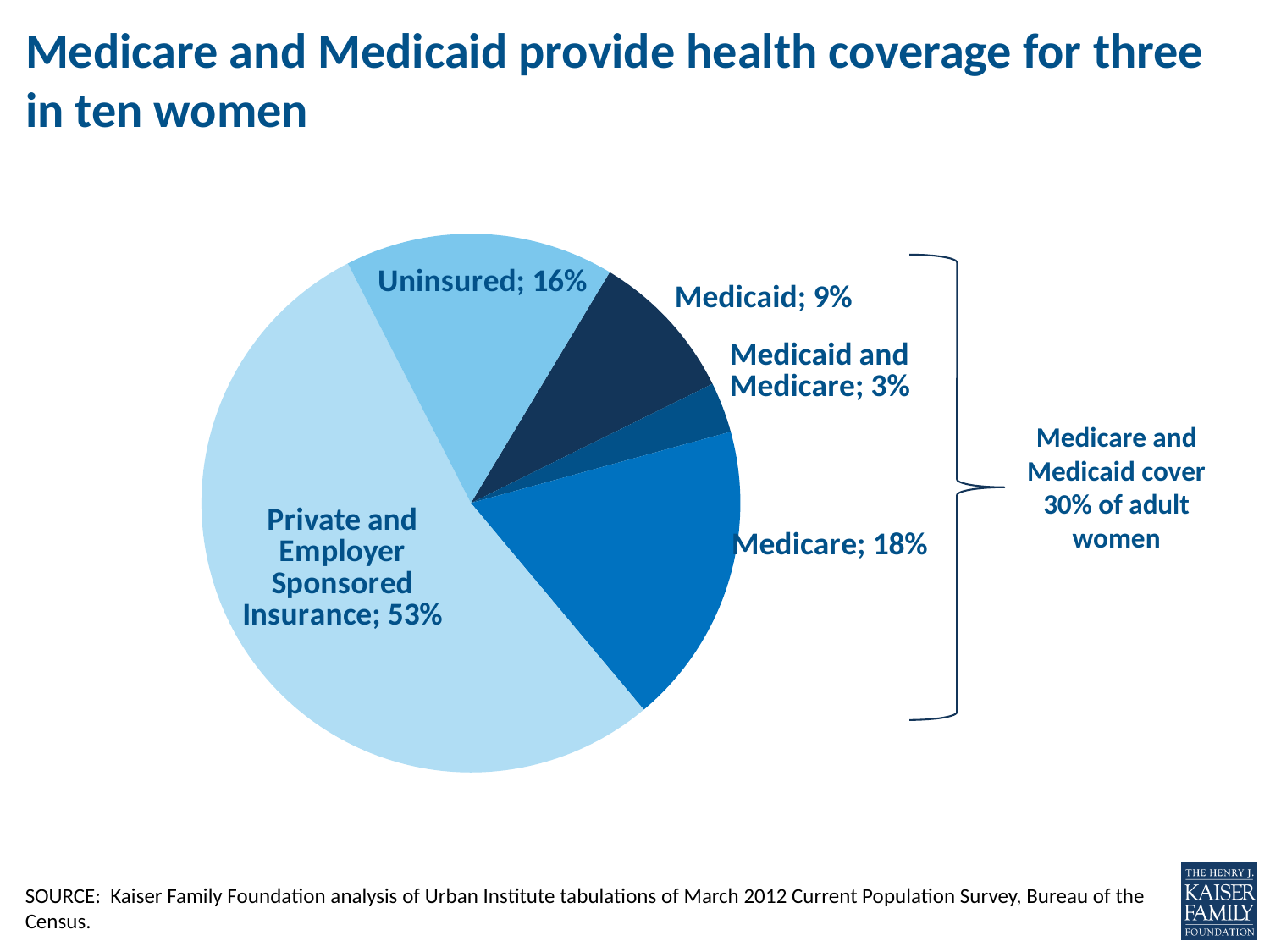
Which is larger, the Uninsured share or the Medicare share? Medicare What percentage of adult women are covered by both Medicaid and Medicare? 3% What type of chart is shown on the slide? Pie chart Which coverage category has the largest share of the pie? Private and Employer Sponsored Insurance What share of adult women have Private and Employer Sponsored Insurance? 53% Which coverage category has the smallest share of the pie? Medicaid and Medicare How many percentage points larger is the Medicare share than the Medicaid share? 9 What percentage of adult women are covered by Medicare? 18% What percentage of adult women are Uninsured? 16% What percentage of adult women are covered by Medicaid? 9% How many slices does the pie chart have? 5 According to the bracket annotation, what percentage of adult women do Medicare and Medicaid cover combined? 30%